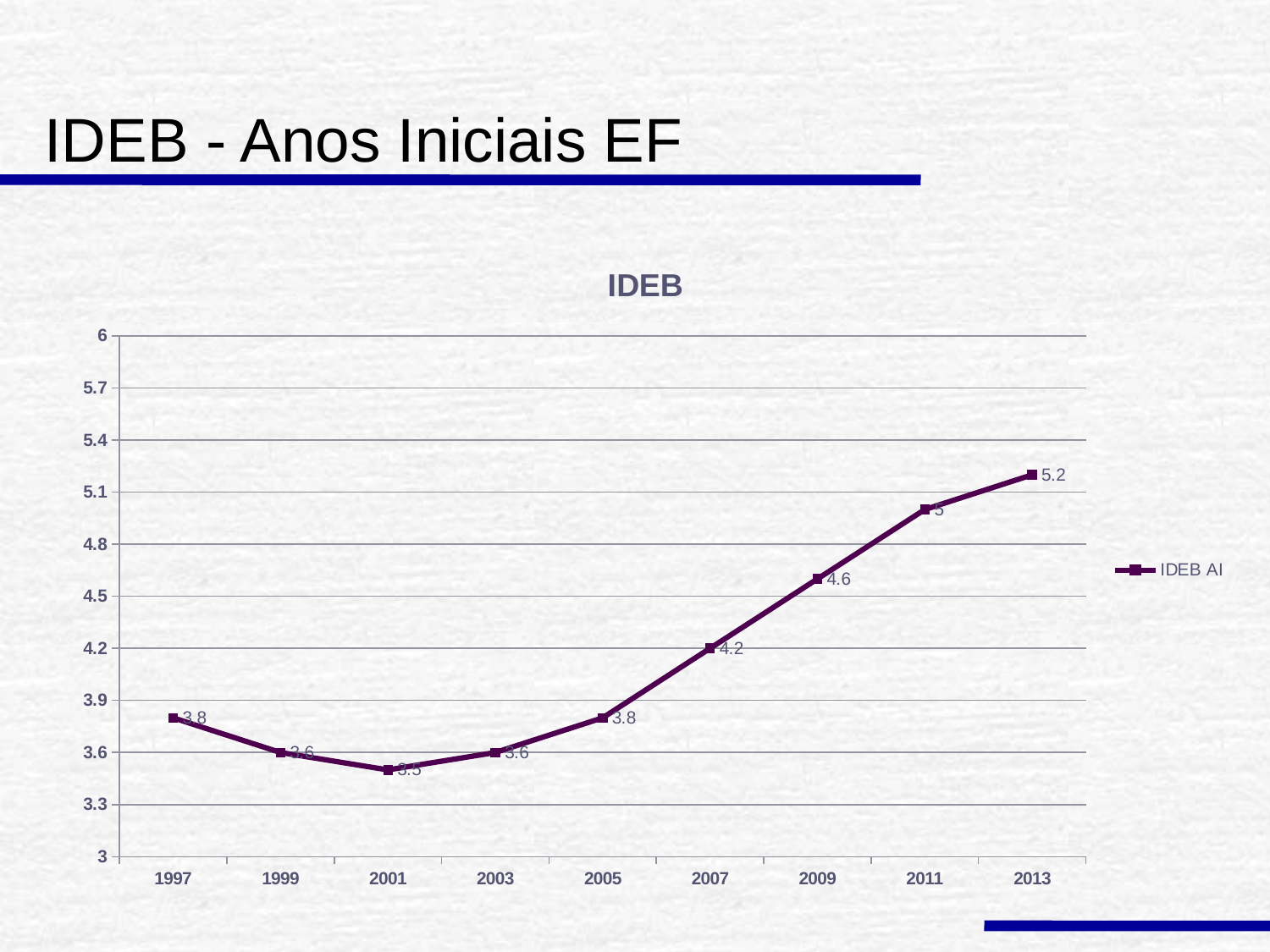
What is the IDEB AI value for 2013? 5.2 Which year has a larger IDEB AI value, 2007 or 2011? 2011 Which year has the highest IDEB AI value? 2013 Do the IDEB AI values rise or fall from 2005 to 2013? rise What is the difference between the IDEB AI values for 2013 and 1997? 1.4 What is the IDEB AI value for 2009? 4.6 How many years are plotted on the x axis? 9 What is the IDEB AI value for 2001? 3.5 Which year has the lowest IDEB AI value? 2001 Is the IDEB AI value for 2011 greater or less than 4.8? greater What kind of chart is shown? line chart How many series does the legend list? 1